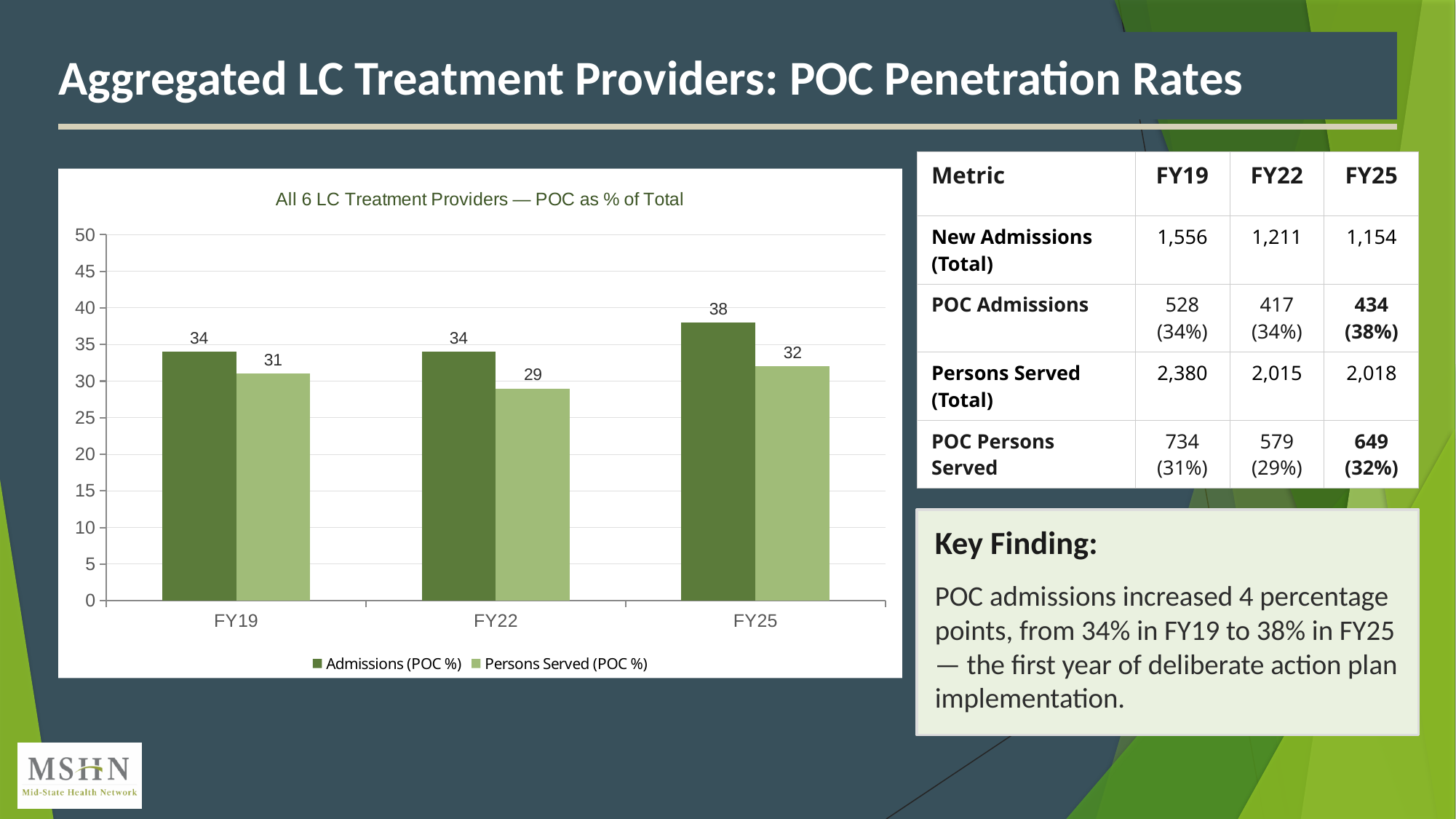
What kind of chart is shown on the slide? Bar chart What is the Persons Served (POC %) value for FY19? 31 What is the Admissions (POC %) value for FY25? 38 Which is larger: the Persons Served (POC %) value for FY19 or for FY25? FY25 Which fiscal year has the highest Admissions (POC %) value? FY25 What is the difference between the Admissions (POC %) values for FY25 and FY19? 4 What is the difference between the Admissions (POC %) value and the Persons Served (POC %) value for FY25? 6 How many series does the chart legend list? 2 How many fiscal years are shown on the x axis of the chart? 3 What is the title of the chart? All 6 LC Treatment Providers — POC as % of Total What is the Persons Served (POC %) value for FY22? 29 Which fiscal year has the lowest Persons Served (POC %) value? FY22